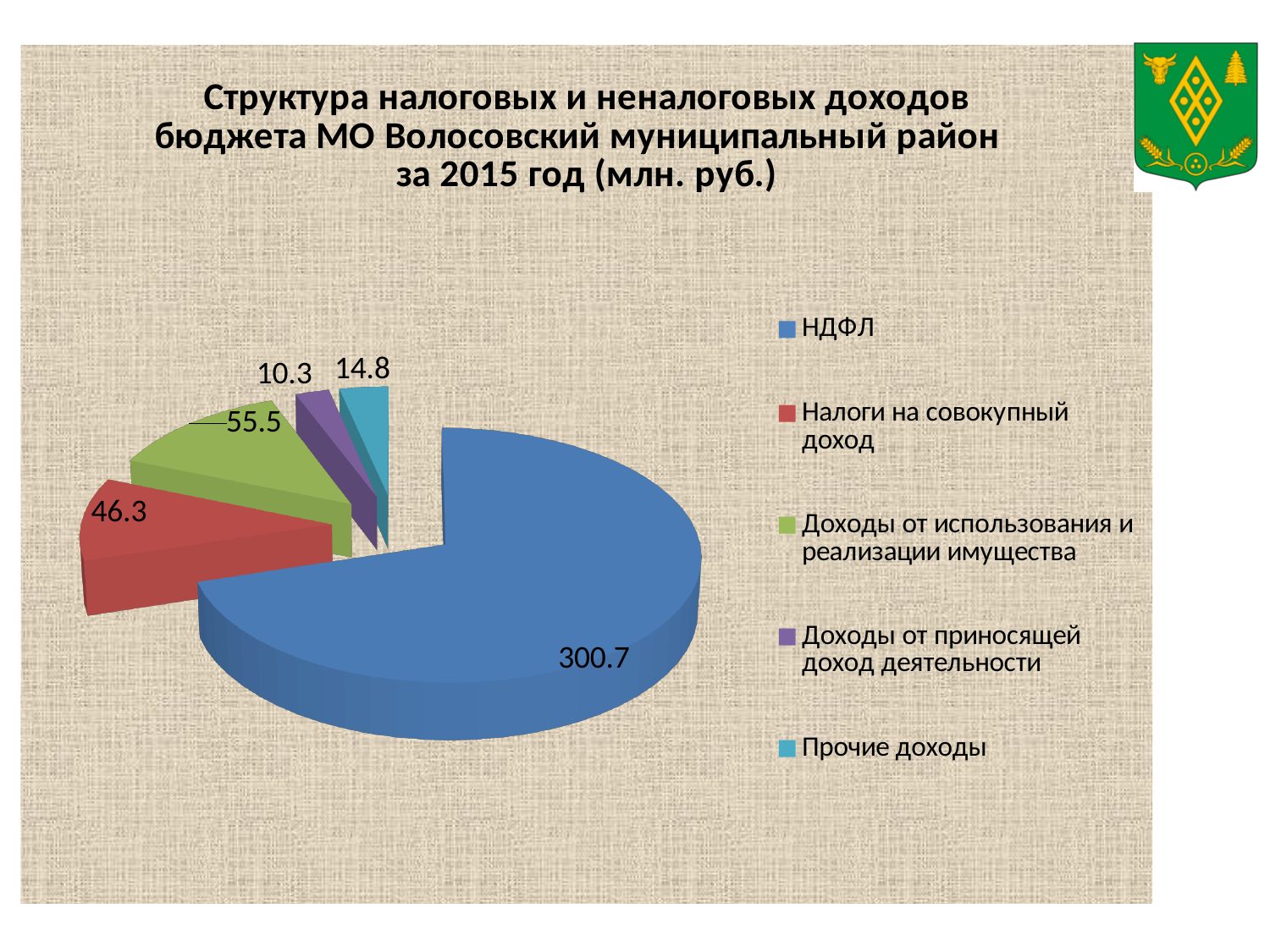
Which category has the largest value? НДФЛ What is the value for Налоги на совокупный доход? 46.3 What is the value for Прочие доходы? 14.8 What is the value for Доходы от использования и реализации имущества? 55.5 What colour is the slice for НДФЛ? Blue Which category has the smallest value? Доходы от приносящей доход деятельности What is the value for НДФЛ? 300.7 What type of chart is shown on the slide? Pie chart What is the difference between Доходы от использования и реализации имущества and Налоги на совокупный доход? 9.2 Which is larger: Прочие доходы or Доходы от приносящей доход деятельности? Прочие доходы How many categories does the pie chart have? 5 What is the value for Доходы от приносящей доход деятельности? 10.3